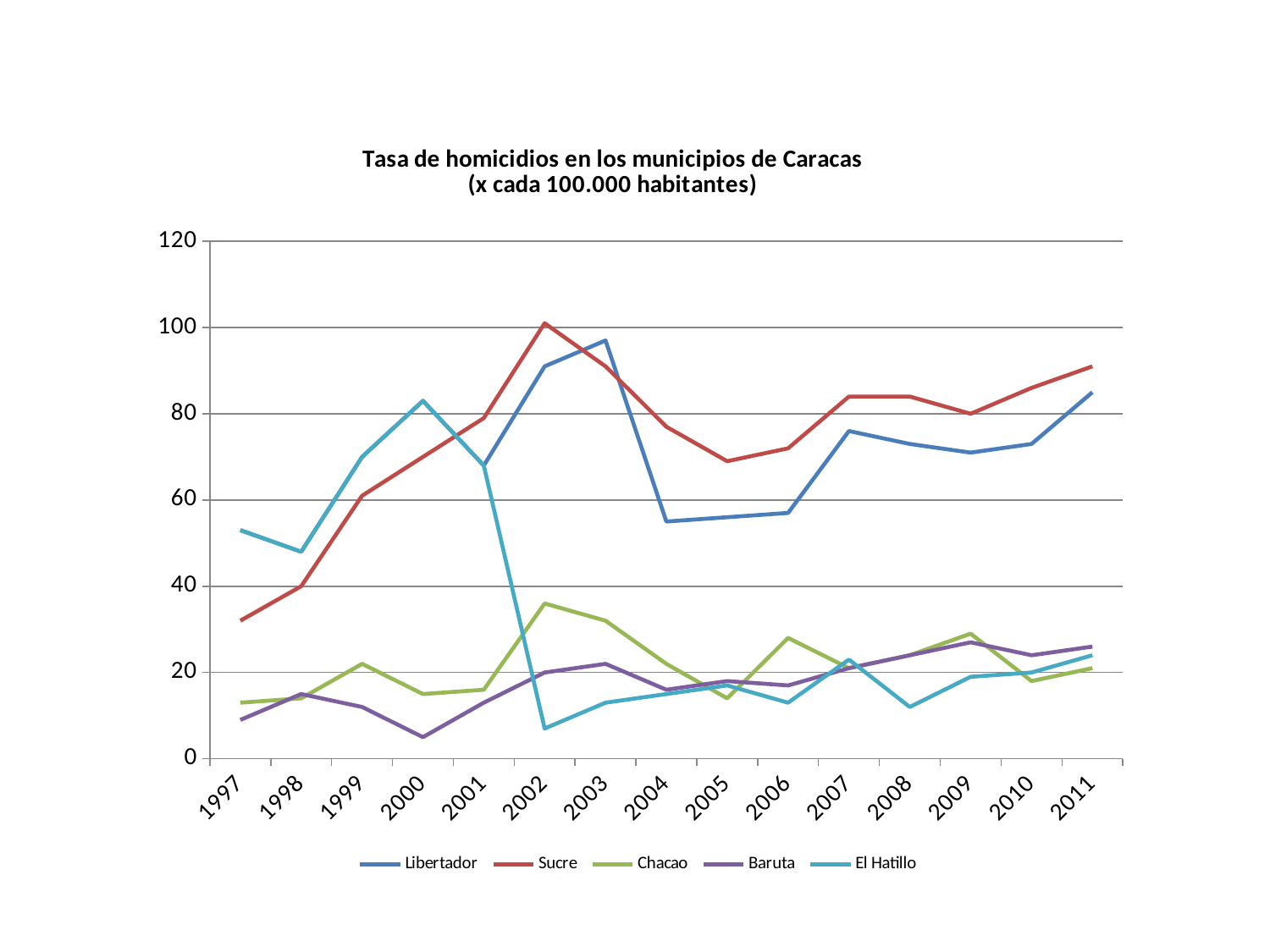
Which series has the highest value in 2003? Libertador In which year does the Sucre series reach its highest value? 2002 Is the value for Sucre in 2002 greater or less than 80? greater Is the value for El Hatillo in 2002 greater or less than 20? less Is the value for Baruta in 2000 greater or less than 20? less Which series has the higher value in 2004, Sucre or Libertador? Sucre Does the Sucre series rise or fall from 1997 to 2002? rise In which year does the Baruta series reach its lowest value? 2000 What is the title of the chart? Tasa de homicidios en los municipios de Caracas (x cada 100.000 habitantes) What kind of chart is shown on the slide? line chart How many years are shown on the x axis? 15 How many series does the legend list? 5